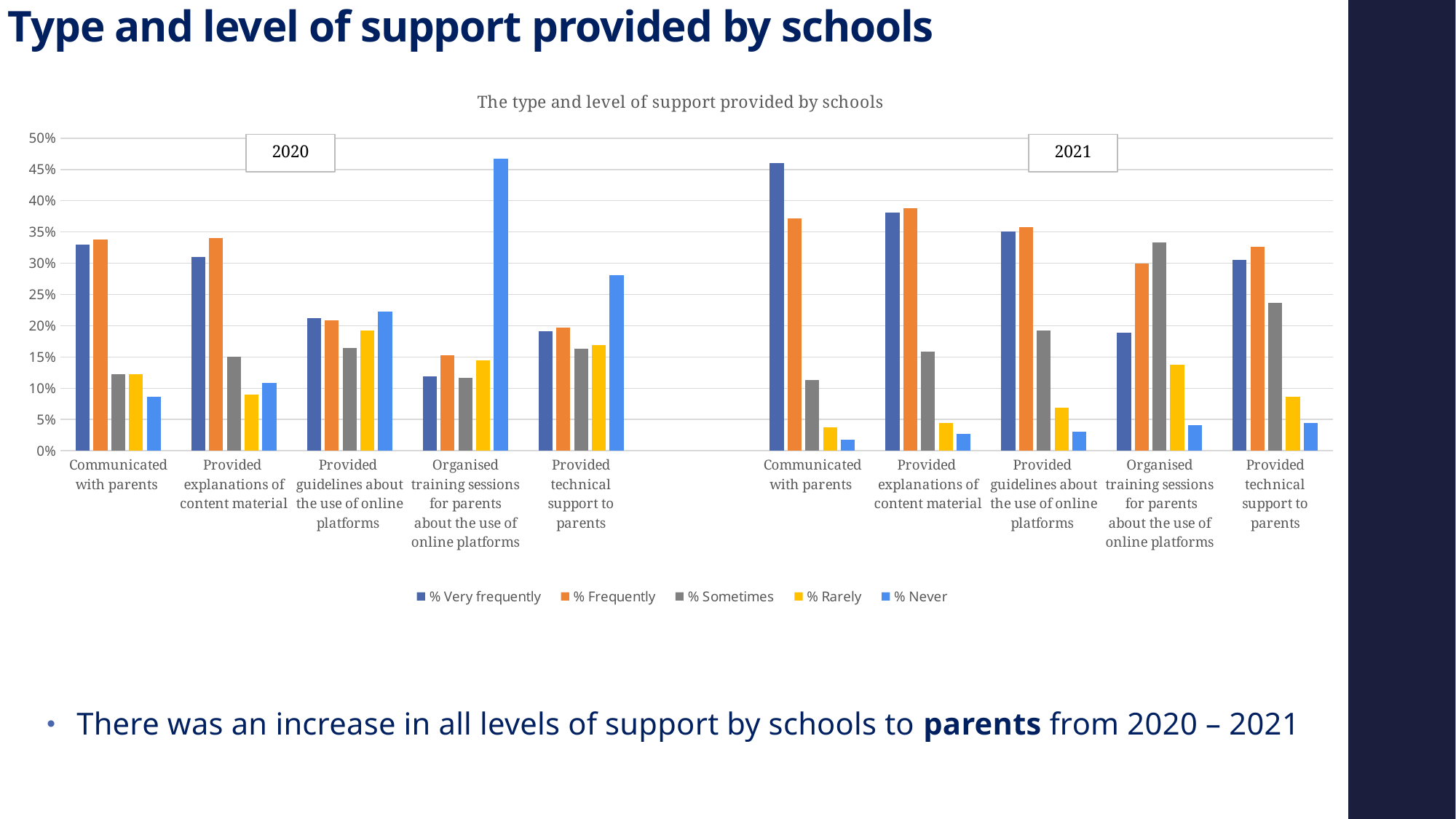
What kind of chart is shown on the slide? bar chart Is the 2020 value of % Never for 'Organised training sessions for parents about the use of online platforms' greater or less than 45%? greater In 2021, which category has the lowest % Very frequently value? Organised training sessions for parents about the use of online platforms Is the 2021 value of % Never for 'Communicated with parents' greater or less than 5%? less What is the title of the chart? The type and level of support provided by schools For 'Organised training sessions for parents about the use of online platforms' in 2021, which series has the highest value? % Sometimes In 2020, which category has the highest % Never value? Organised training sessions for parents about the use of online platforms How many series does the legend list? 5 Which is larger in 2020: % Never for 'Organised training sessions for parents about the use of online platforms' or % Never for 'Provided technical support to parents'? Organised training sessions for parents about the use of online platforms For 'Communicated with parents' in 2021, which is larger: % Very frequently or % Frequently? % Very frequently Is the 2021 value of % Very frequently for 'Communicated with parents' greater or less than 40%? greater How many support categories are shown under the 2020 label? 5